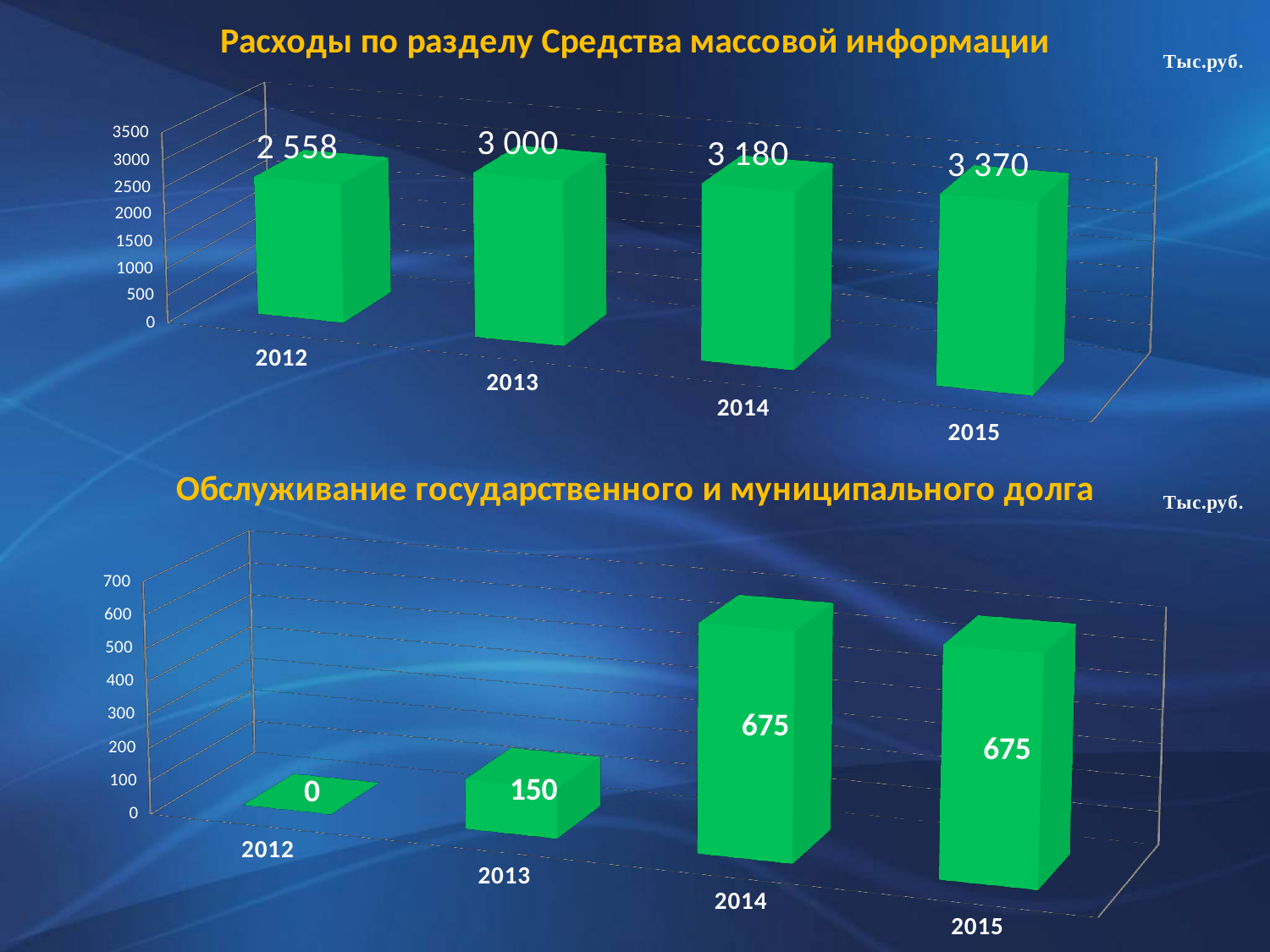
In the top chart (Расходы по разделу Средства массовой информации), what is the value for 2012? 2 558 In the bottom chart (Обслуживание государственного и муниципального долга), which is larger, the value for 2013 or the value for 2015? 2015 In the bottom chart (Обслуживание государственного и муниципального долга), what is the value for 2013? 150 In the top chart (Расходы по разделу Средства массовой информации), what is the value for 2015? 3 370 What kind of chart is the top chart (Расходы по разделу Средства массовой информации)? bar chart In the top chart (Расходы по разделу Средства массовой информации), which year has the highest value? 2015 In the bottom chart (Обслуживание государственного и муниципального долга), what is the difference between the values for 2014 and 2013? 525 In the top chart (Расходы по разделу Средства массовой информации), what is the difference between the values for 2014 and 2013? 180 How many years are shown in the bottom chart (Обслуживание государственного и муниципального долга)? 4 In the top chart (Расходы по разделу Средства массовой информации), which year has the lowest value? 2012 In the bottom chart (Обслуживание государственного и муниципального долга), what is the value for 2012? 0 In the top chart (Расходы по разделу Средства массовой информации), do the values rise or fall from 2012 to 2015? rise